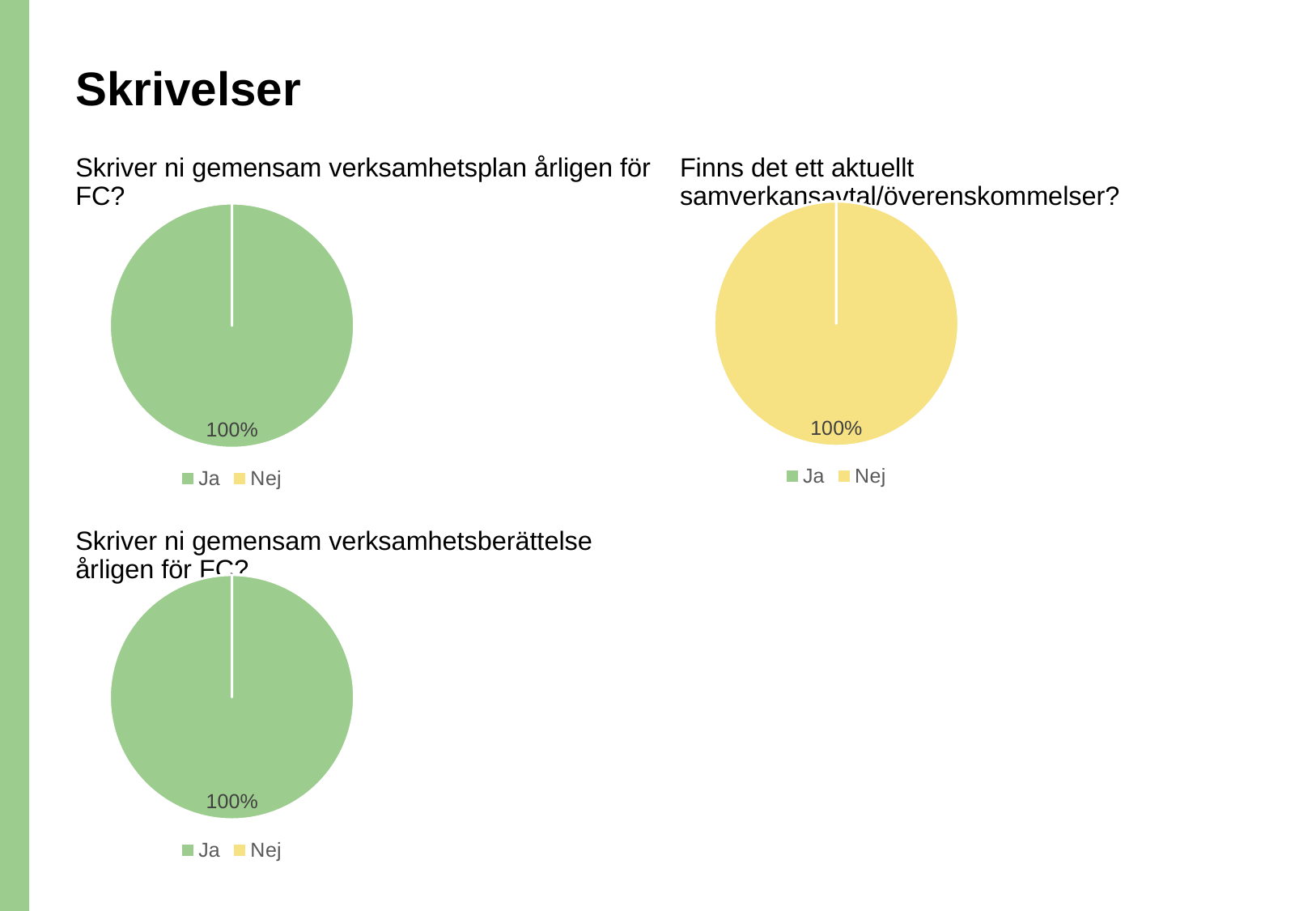
In the chart "Finns det ett aktuellt samverkansavtal/överenskommelser?", what colour represents Nej in the legend? yellow In the chart "Skriver ni gemensam verksamhetsberättelse årligen för FC?", what share of the pie is Ja? 100% What is the title of the slide? Skrivelser In the chart "Finns det ett aktuellt samverkansavtal/överenskommelser?", which category makes up the whole pie? Nej What is the value labelled on the pie in the chart "Skriver ni gemensam verksamhetsberättelse årligen för FC?"? 100% How many entries does the legend list in the chart "Finns det ett aktuellt samverkansavtal/överenskommelser?"? 2 How many pie charts are shown on the slide? 3 In the chart "Skriver ni gemensam verksamhetsberättelse årligen för FC?", which category makes up the whole pie? Ja In the chart "Finns det ett aktuellt samverkansavtal/överenskommelser?", what share of the pie is Nej? 100% What kind of chart is used for "Skriver ni gemensam verksamhetsplan årligen för FC?"? pie chart In the chart "Skriver ni gemensam verksamhetsplan årligen för FC?", what share of the pie is Ja? 100% In the chart "Skriver ni gemensam verksamhetsplan årligen för FC?", which category makes up the whole pie? Ja